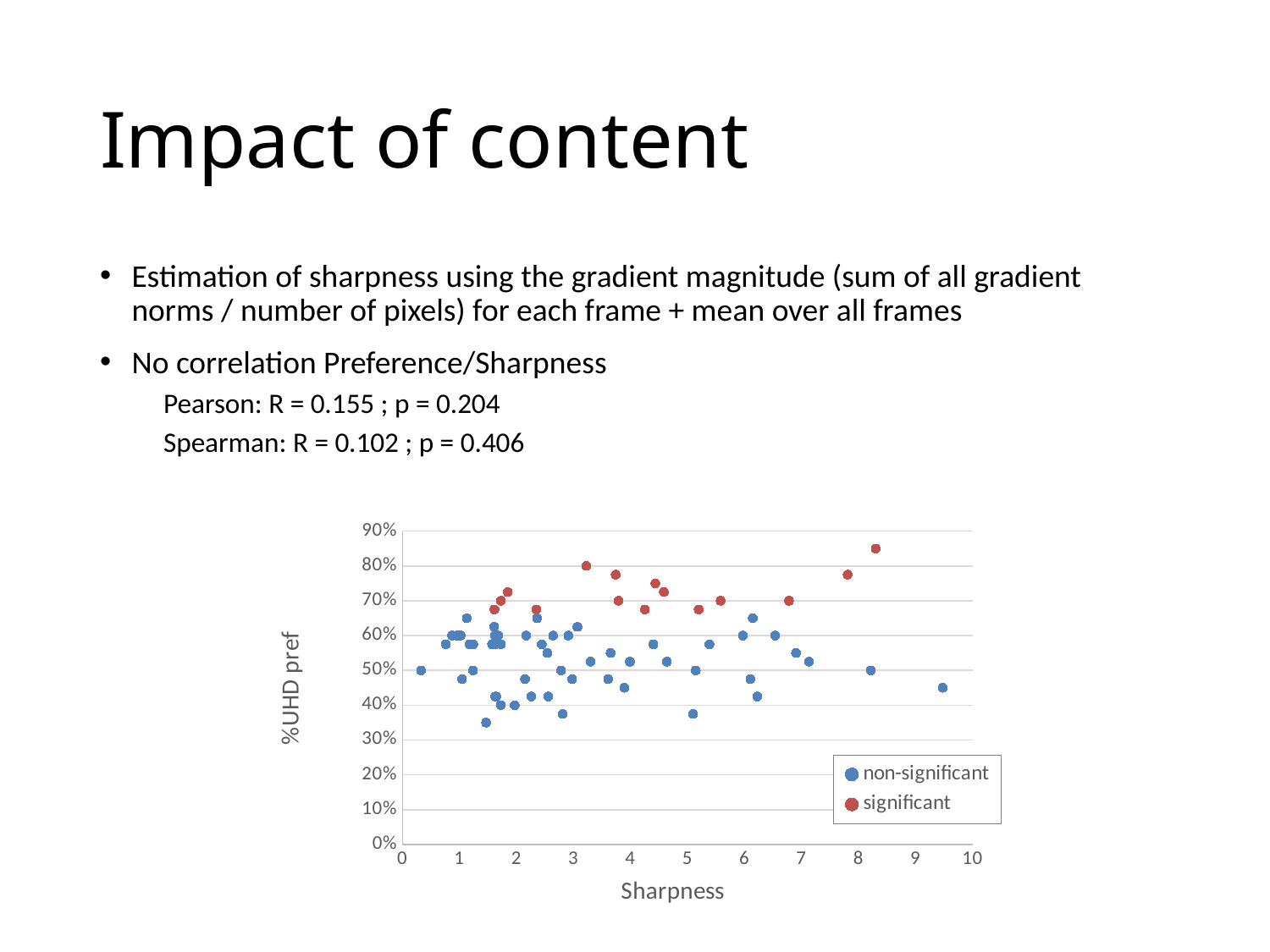
Which series contains the highest point on the chart? significant What are the two series named in the chart legend? non-significant and significant What is the highest value shown on the Sharpness axis? 10 Is the lowest point on the chart greater or less than 40%? less What kind of chart is shown on the slide? scatter chart Is the highest point on the chart greater or less than 80%? greater What is the label of the vertical axis of the chart? %UHD pref Which series has the higher maximum %UHD pref value, significant or non-significant? significant How many series does the chart legend list? 2 Is the point with the largest Sharpness value greater or less than 50% on the %UHD pref axis? less Which series contains the lowest point on the chart? non-significant